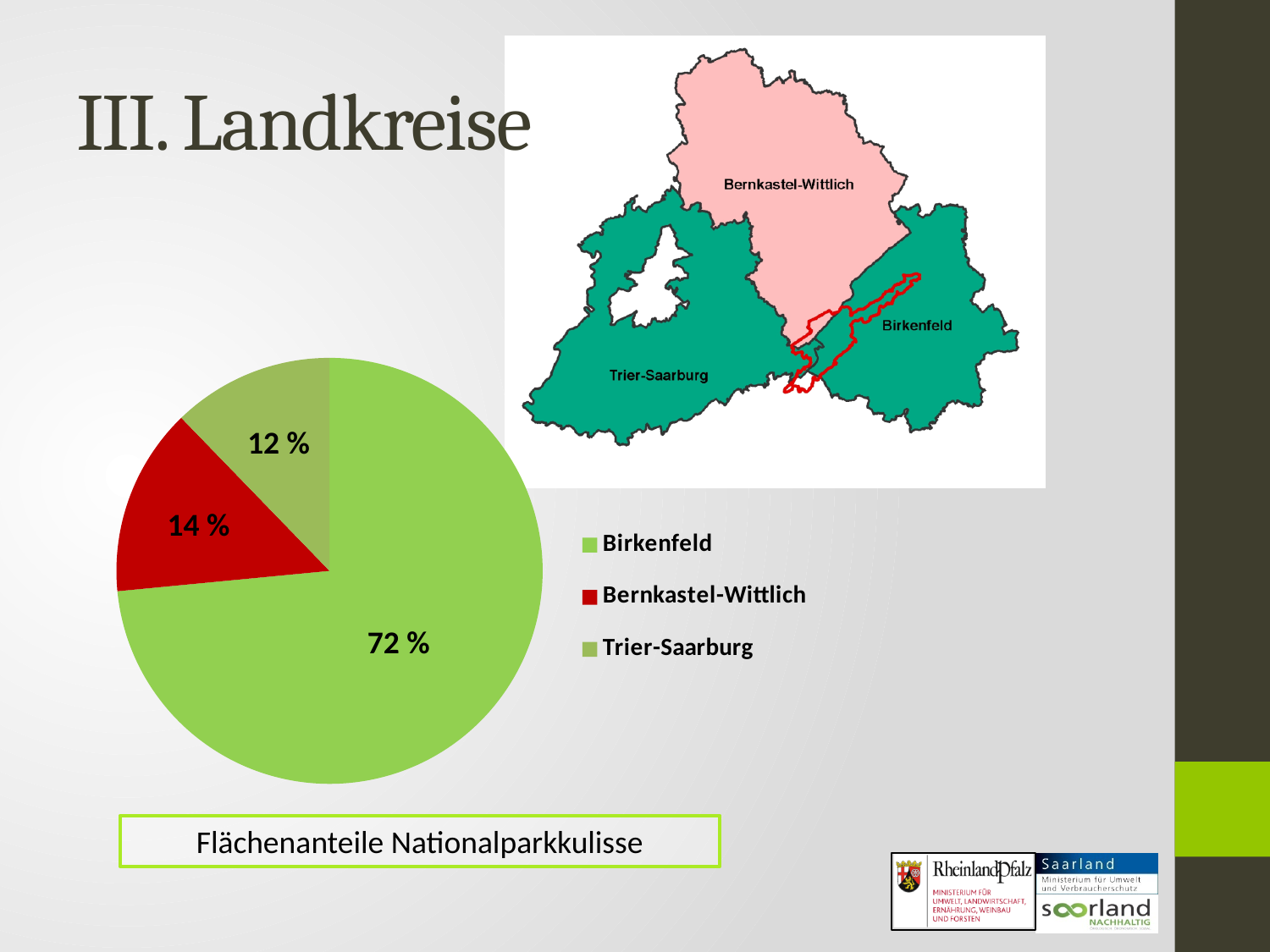
How many slices does the pie chart have? 3 What is the difference in percentage points between the shares of Bernkastel-Wittlich and Trier-Saarburg? 2 What share of the pie chart does Trier-Saarburg have? 12 % Which Landkreis has the largest share in the pie chart? Birkenfeld What share of the pie chart does Birkenfeld have? 72 % Which Landkreis has the smallest share in the pie chart? Trier-Saarburg How many entries does the legend of the pie chart list? 3 Which has a larger share in the pie chart, Bernkastel-Wittlich or Trier-Saarburg? Bernkastel-Wittlich What share of the pie chart does Bernkastel-Wittlich have? 14 % What kind of chart is shown on the slide? Pie chart What is the difference in percentage points between the shares of Birkenfeld and Bernkastel-Wittlich? 58 What is the caption below the pie chart? Flächenanteile Nationalparkkulisse